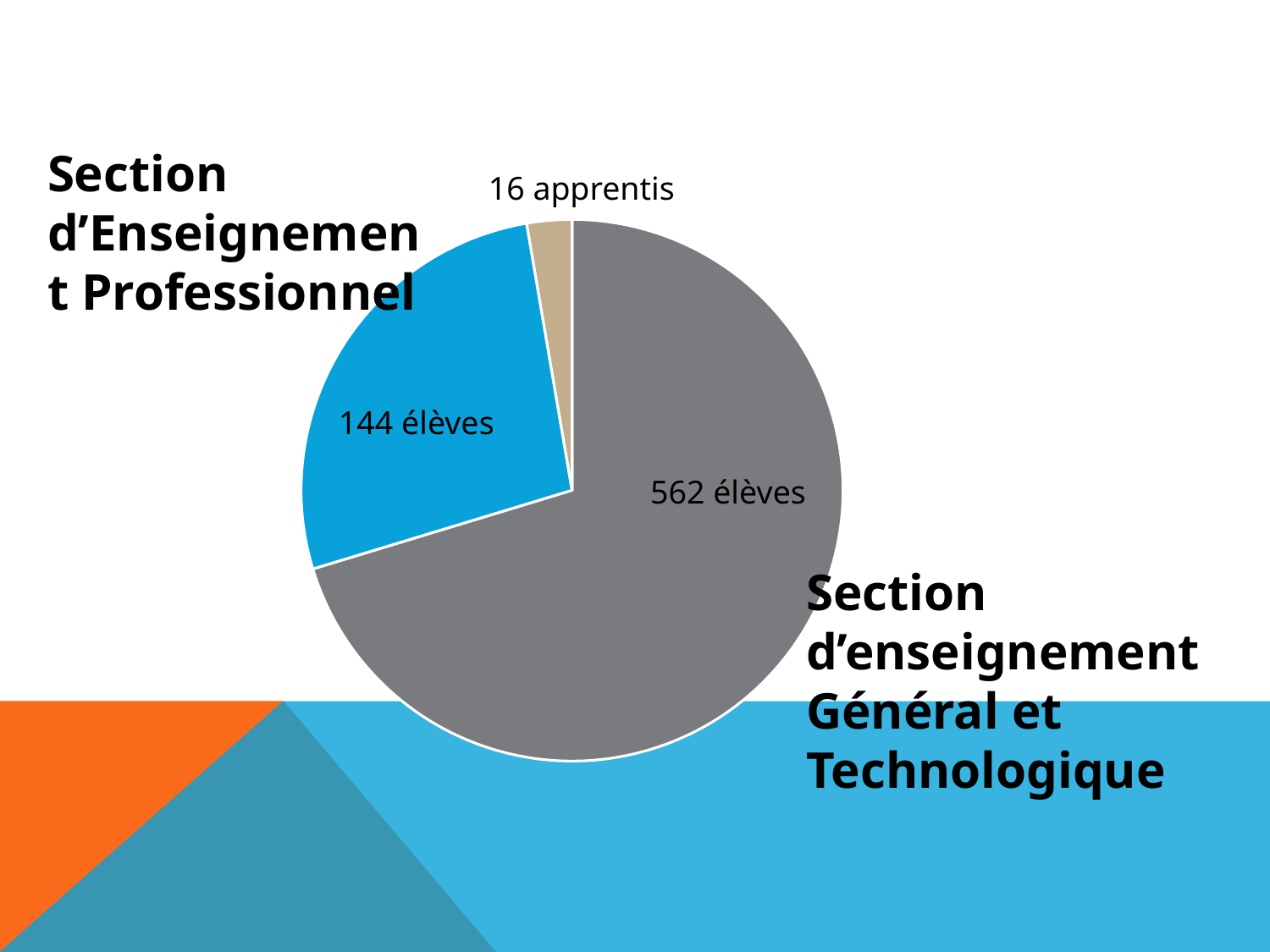
What is the total of all three slices in the pie chart? 722 Which slice of the pie chart is the smallest? 16 apprentis How many slices does the pie chart have? 3 Which slice of the pie chart is the largest? 562 élèves (Section d'enseignement Général et Technologique) Which is larger: the Section d'Enseignement Professionnel slice or the Section d'enseignement Général et Technologique slice? Section d'enseignement Général et Technologique How many élèves are in the Section d'enseignement Général et Technologique slice? 562 élèves What colour is the slice labelled 144 élèves? blue What is the value of the smallest slice of the pie chart? 16 apprentis What colour is the slice labelled 562 élèves? grey What kind of chart is shown on the slide? pie chart How many élèves are in the Section d'Enseignement Professionnel slice? 144 élèves What is the difference between the 562 élèves slice and the 144 élèves slice? 418